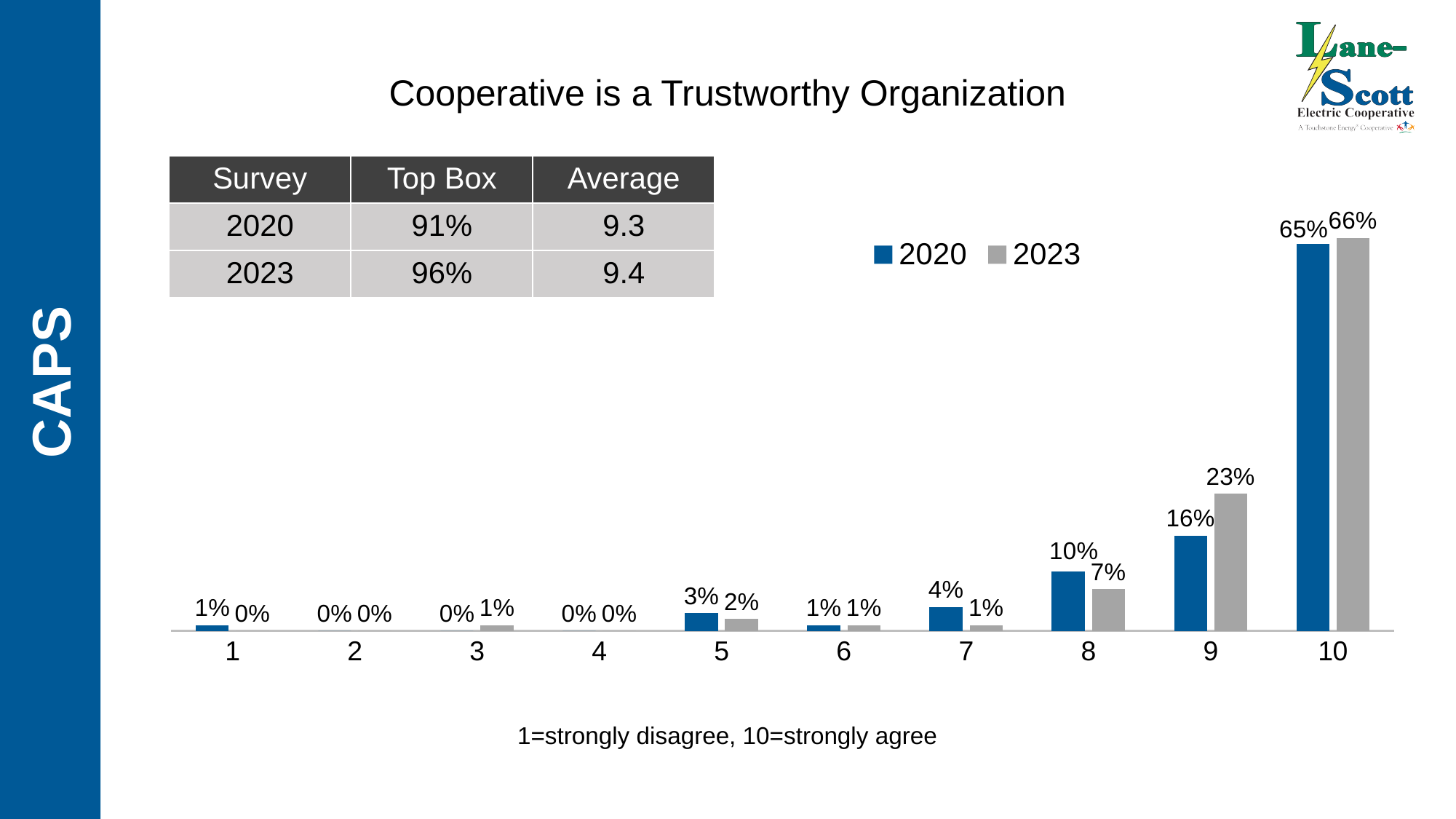
How many rating categories are shown on the x axis? 10 Which rating has the highest 2023 value? 10 What kind of chart is shown on the slide? Bar chart What is the difference between the 2023 and 2020 values for rating 9? 7% What is the 2023 value for rating 7? 1% For rating 7, which series has the larger value, 2020 or 2023? 2020 What is the title of the chart? Cooperative is a Trustworthy Organization What is the 2023 value for rating 9? 23% What is the difference between the 2020 and 2023 values for rating 8? 3% What is the 2020 value for rating 8? 10% How many series does the legend list? 2 What is the 2020 value for rating 10? 65%